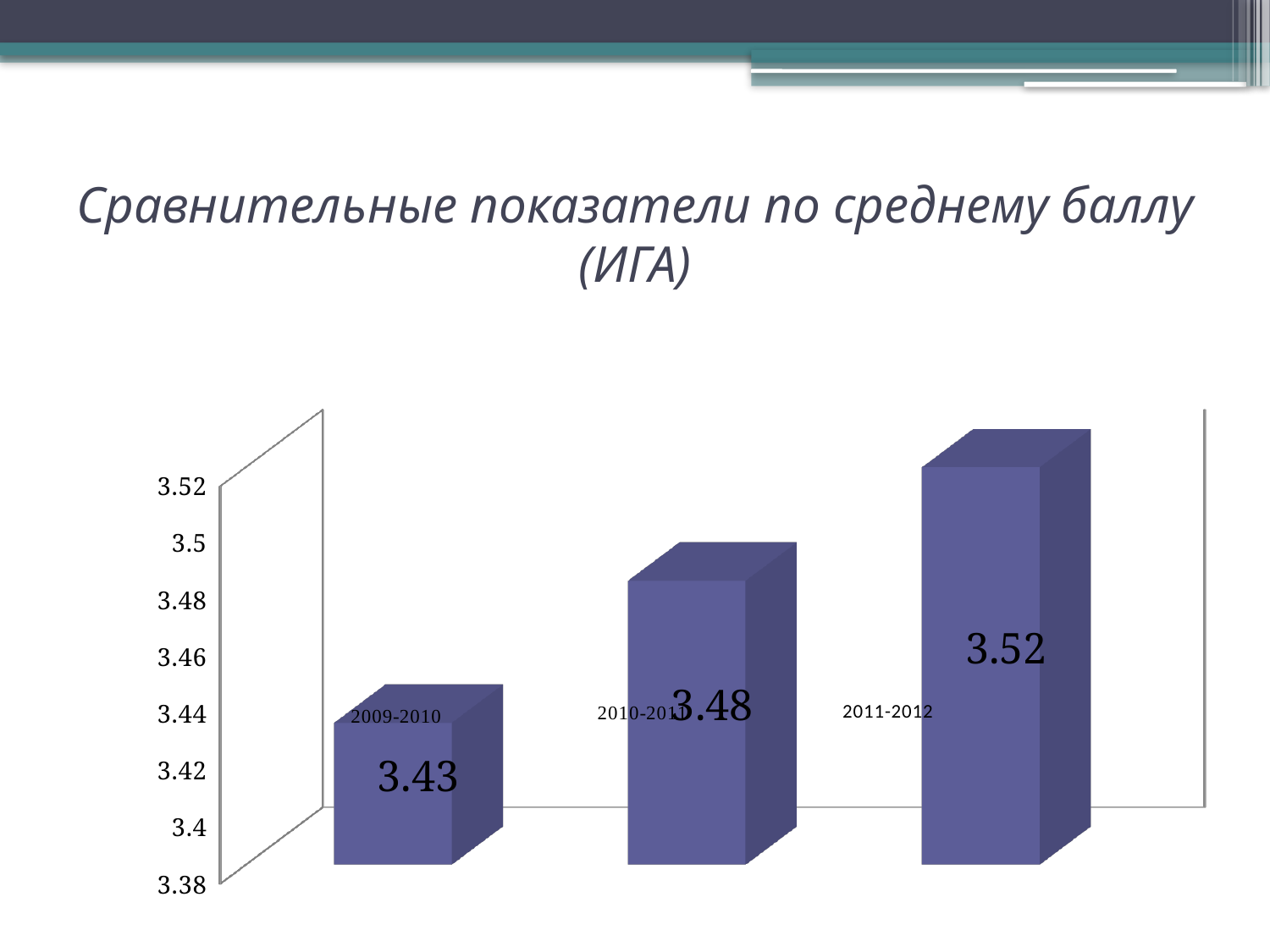
Which period has the highest value? 2011-2012 What is the value for 2009-2010? 3.43 What is the value for 2010-2011? 3.48 How many periods are shown in the chart? 3 What is the difference between the values for 2011-2012 and 2009-2010? 0.09 What is the difference between the values for 2010-2011 and 2009-2010? 0.05 Is the value for 2009-2010 greater or less than 3.46? less Which period has the lowest value? 2009-2010 What is the value for 2011-2012? 3.52 Which is larger, the value for 2010-2011 or the value for 2011-2012? 2011-2012 What kind of chart is shown on the slide? bar chart Do the values rise or fall from 2009-2010 to 2011-2012? rise